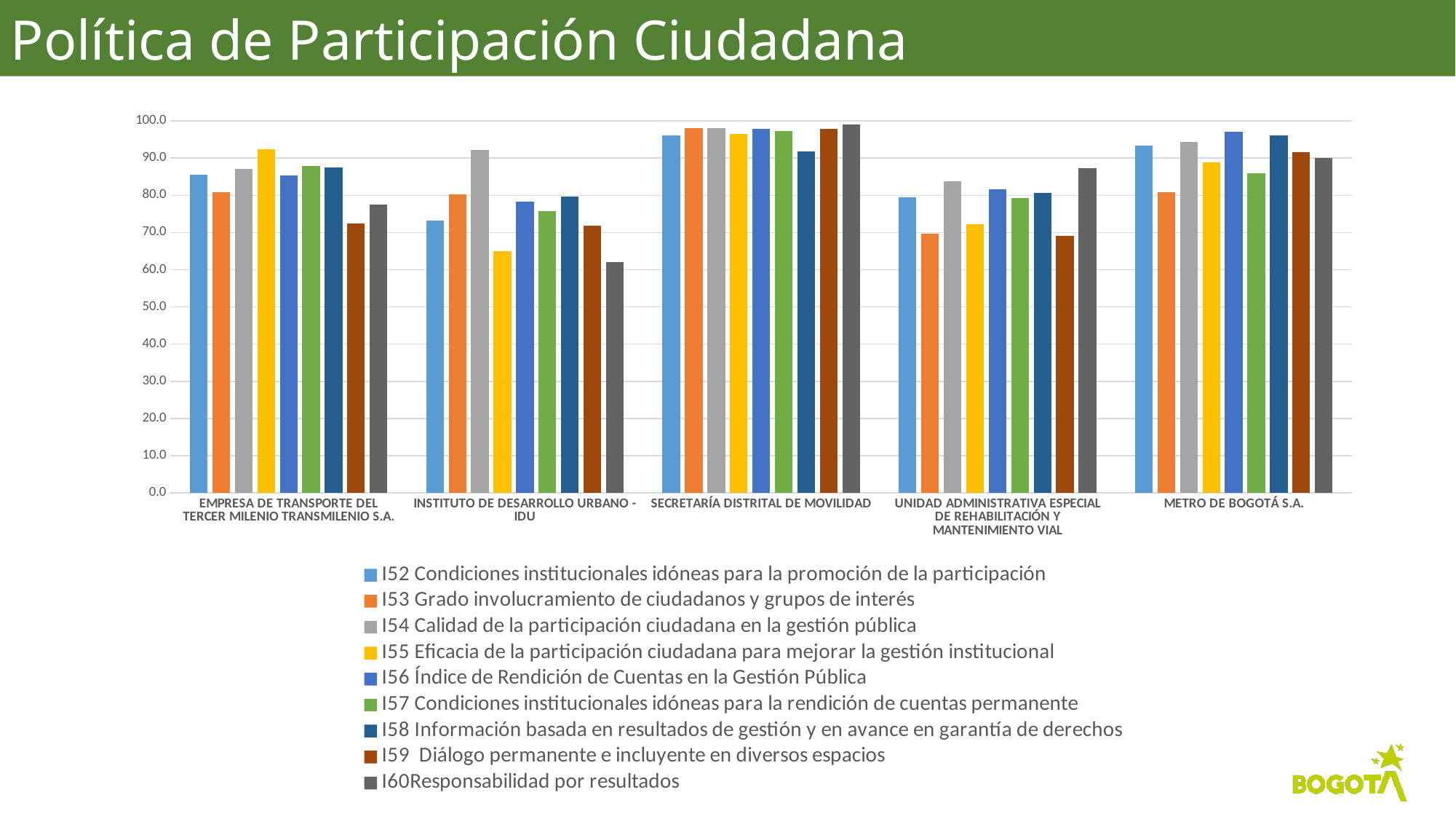
How many entities (categories) are shown on the x axis of the chart? 5 For INSTITUTO DE DESARROLLO URBANO - IDU, which is larger: I54 Calidad de la participación ciudadana or I55 Eficacia de la participación ciudadana? I54 Calidad de la participación ciudadana en la gestión pública Which series has the lowest value for SECRETARÍA DISTRITAL DE MOVILIDAD? I58 Información basada en resultados de gestión y en avance en garantía de derechos Is the value of I55 Eficacia de la participación ciudadana for INSTITUTO DE DESARROLLO URBANO - IDU greater or less than 70.0? less Is the value of I52 Condiciones institucionales idóneas para la promoción de la participación for SECRETARÍA DISTRITAL DE MOVILIDAD greater or less than 90.0? greater How many series does the legend list? 9 What kind of chart is shown on the slide? bar chart Is the value of I53 Grado involucramiento de ciudadanos y grupos de interés for UNIDAD ADMINISTRATIVA ESPECIAL DE REHABILITACIÓN Y MANTENIMIENTO VIAL greater or less than 80.0? less What is the title shown at the top of the slide? Política de Participación Ciudadana Which series has the highest value for INSTITUTO DE DESARROLLO URBANO - IDU? I54 Calidad de la participación ciudadana en la gestión pública For SECRETARÍA DISTRITAL DE MOVILIDAD, which is larger: I60 Responsabilidad por resultados or I58 Información basada en resultados de gestión? I60 Responsabilidad por resultados